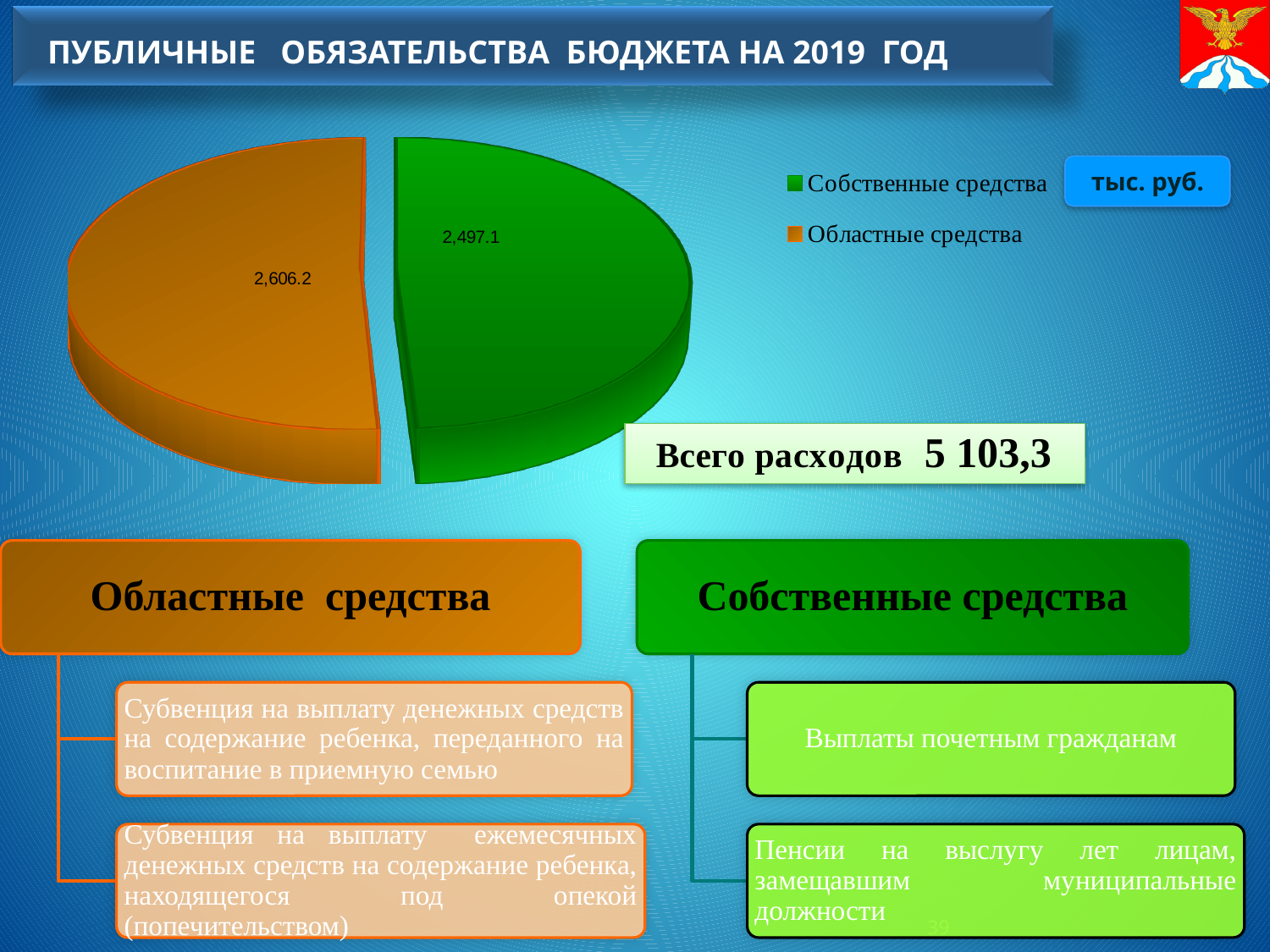
Which category has the smallest slice in the pie chart? Собственные средства Which is larger, Собственные средства or Областные средства? Областные средства What is the value for Областные средства in the pie chart? 2,606.2 What is the difference between Областные средства and Собственные средства? 109.1 In what units are the chart values given, according to the label next to the legend? тыс. руб. What is the value for Собственные средства in the pie chart? 2,497.1 What total expenditure (Всего расходов) is shown next to the chart? 5 103,3 How many entries does the legend list? 2 How many slices does the pie chart have? 2 What colour is the slice for Собственные средства? Green What type of chart is shown on the slide? Pie chart Which category has the largest slice in the pie chart? Областные средства